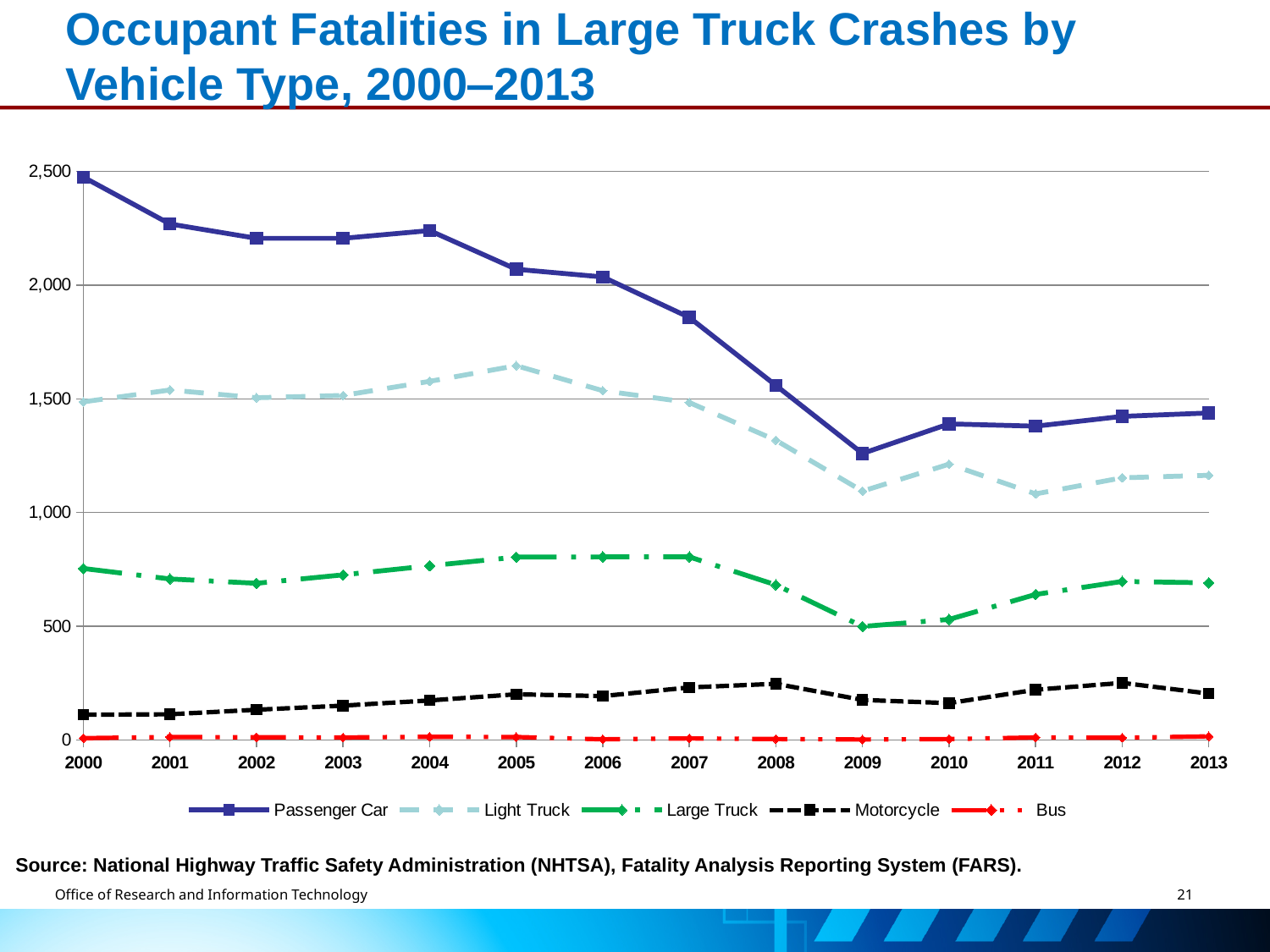
What kind of chart is shown on the slide? Line chart In which year is the Large Truck series at its lowest? 2009 Does the Passenger Car series rise or fall from 2000 to 2009? Fall Is the value for Passenger Car in 2009 greater or less than 1,500? less How many series does the legend list? 5 How many years are plotted along the x axis? 14 Is the value for Light Truck in 2005 greater or less than 1,500? greater In which year is the Passenger Car series at its highest? 2000 Which is larger in 2013, Passenger Car or Light Truck? Passenger Car In which year is the Passenger Car series at its lowest? 2009 Is the value for Passenger Car in 2000 greater or less than 2,000? greater Which vehicle type has the highest occupant fatalities in 2000? Passenger Car